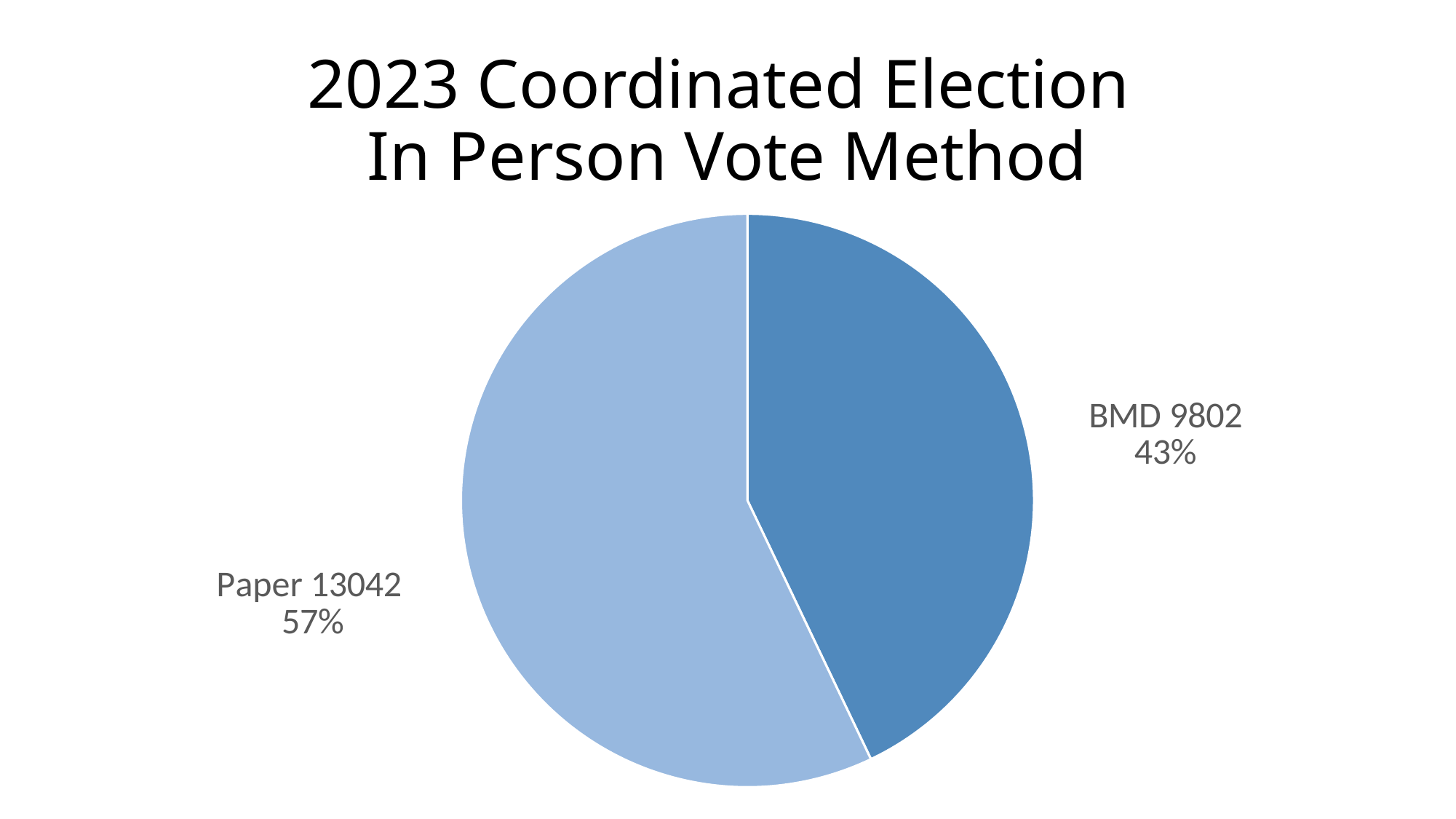
What is the difference between the Paper and BMD values? 3240 What share of the pie does BMD represent? 43% How many slices does the pie chart have? 2 What kind of chart is shown on the slide? pie chart Which is larger, the value for Paper or the value for BMD? Paper Which vote method has the largest slice? Paper Which vote method has the smallest slice? BMD What is the title of the chart? 2023 Coordinated Election In Person Vote Method What is the value for BMD? 9802 What share of the pie does Paper represent? 57% What is the value for Paper? 13042 What is the total of the Paper and BMD values? 22844